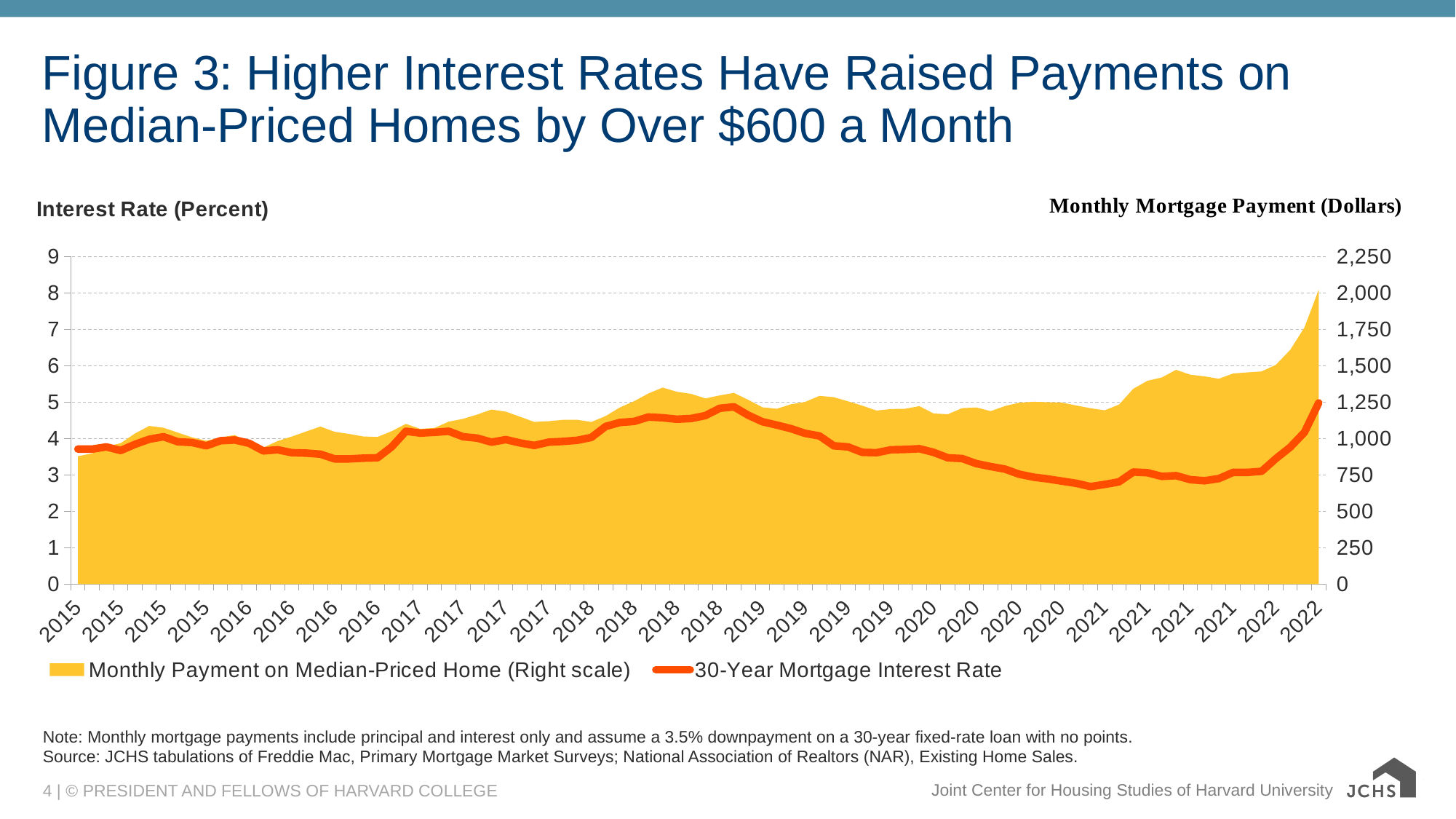
Is the Monthly Payment on Median-Priced Home at the start of 2015 greater or less than 1,000? less In which year does the 30-Year Mortgage Interest Rate reach its lowest value? 2020 Is the lowest value of the 30-Year Mortgage Interest Rate, reached in early 2021, greater or less than 3? less What is the title of the chart? Figure 3: Higher Interest Rates Have Raised Payments on Median-Priced Homes by Over $600 a Month How many series does the legend list? 2 Does the 30-Year Mortgage Interest Rate rise or fall between the end of 2018 and the start of 2021? fall Is the Monthly Payment on Median-Priced Home at the last point in 2022 greater or less than 1,750? greater Does the Monthly Payment on Median-Priced Home rise or fall from 2021 to the end of 2022? rise What is the label of the right-hand vertical axis? Monthly Mortgage Payment (Dollars) In which year does the Monthly Payment on Median-Priced Home reach its highest value? 2022 What kind of chart is this? A combination chart with an area series and a line series